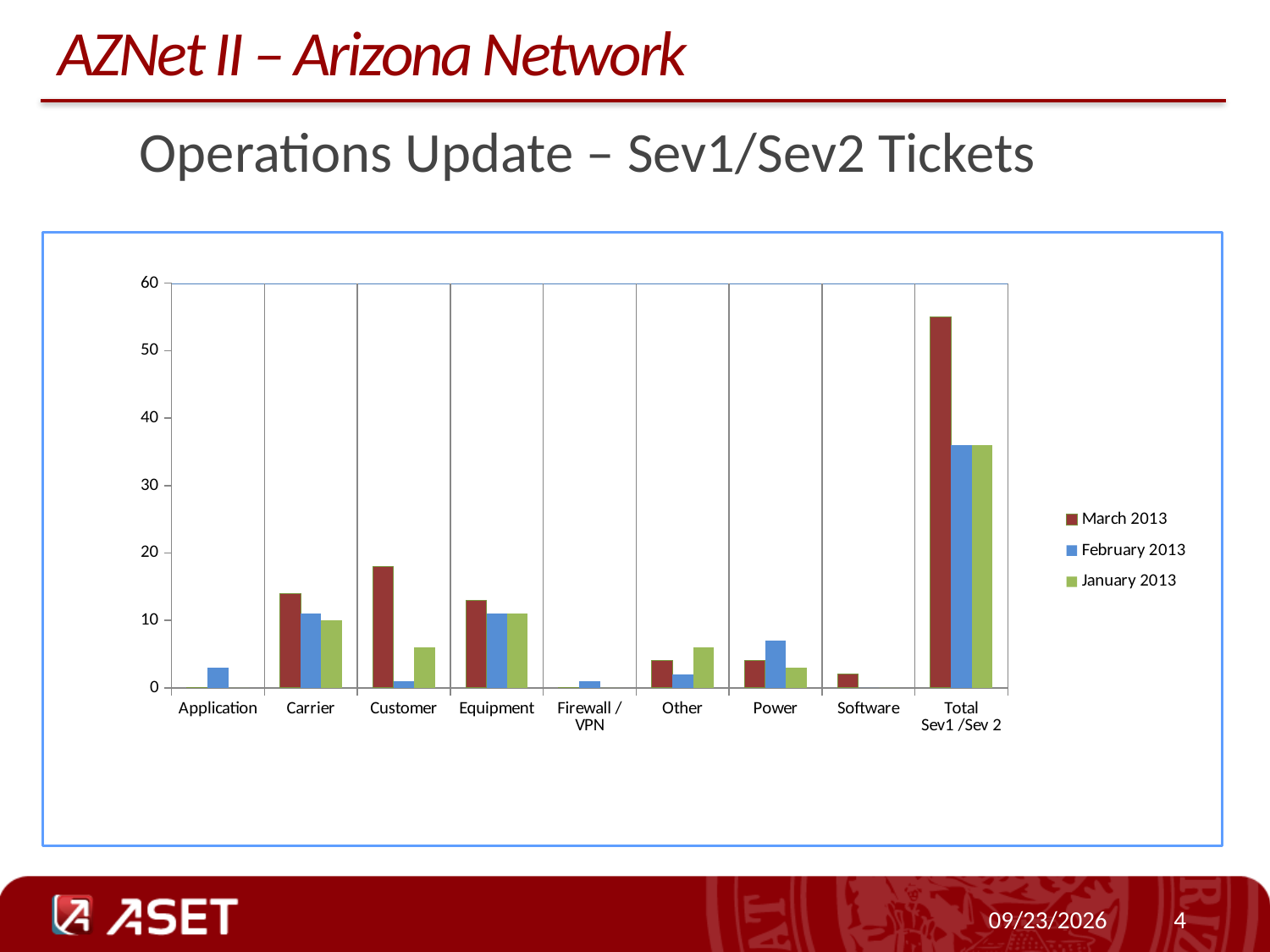
For the Other category, which is larger: January 2013 or March 2013? January 2013 What kind of chart is shown on the slide? bar chart Is the March 2013 value for Total Sev1 /Sev 2 greater or less than 50? greater For the Power category, which is larger: February 2013 or March 2013? February 2013 Which series is shown in dark red in the legend? March 2013 How many series does the legend list? 3 Is the March 2013 value for Customer greater or less than 20? less For March 2013, which is larger: Customer or Carrier? Customer Which category has the highest value for March 2013? Total Sev1 /Sev 2 How many categories are shown along the x axis? 9 Is the February 2013 value for Total Sev1 /Sev 2 greater or less than 40? less